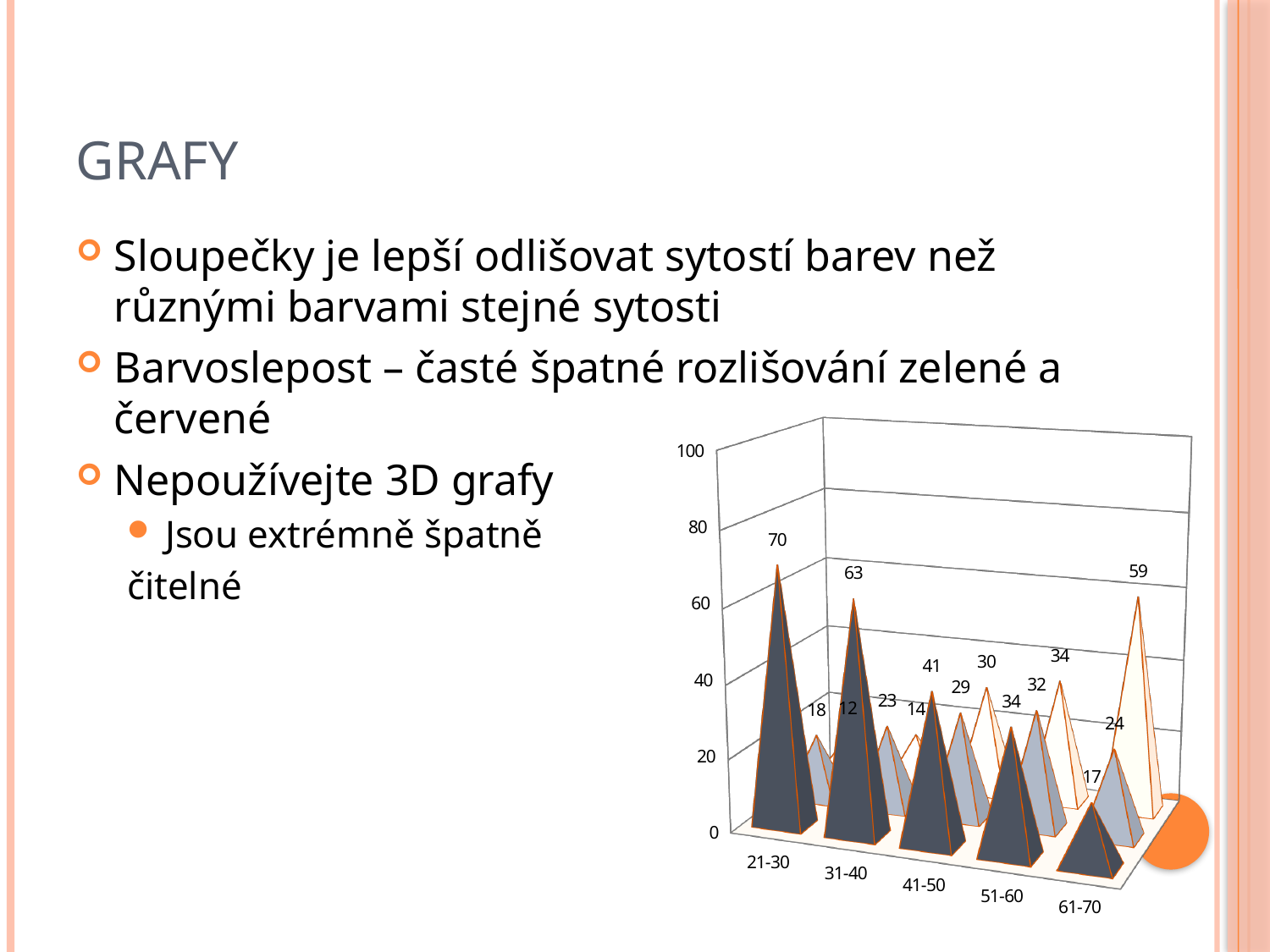
What is the value of the dark front series for the 61-70 category? 17 How many age categories are shown on the x axis of the chart? 5 What is the value of the dark front series for the 31-40 category? 63 What kind of chart is shown on the slide? bar chart What is the value of the dark front series for the 21-30 category? 70 Do the values of the dark front series rise or fall from 21-30 to 61-70? fall Which category has the highest value in the dark front series? 21-30 In the dark front series, which is larger: the value for 21-30 or the value for 41-50? 21-30 Is the dark front series value for 21-30 greater or less than 60? greater What is the difference between the dark front series values for 21-30 and 31-40? 7 Which category has the lowest value in the dark front series? 61-70 What is the maximum value shown on the vertical axis of the chart? 100